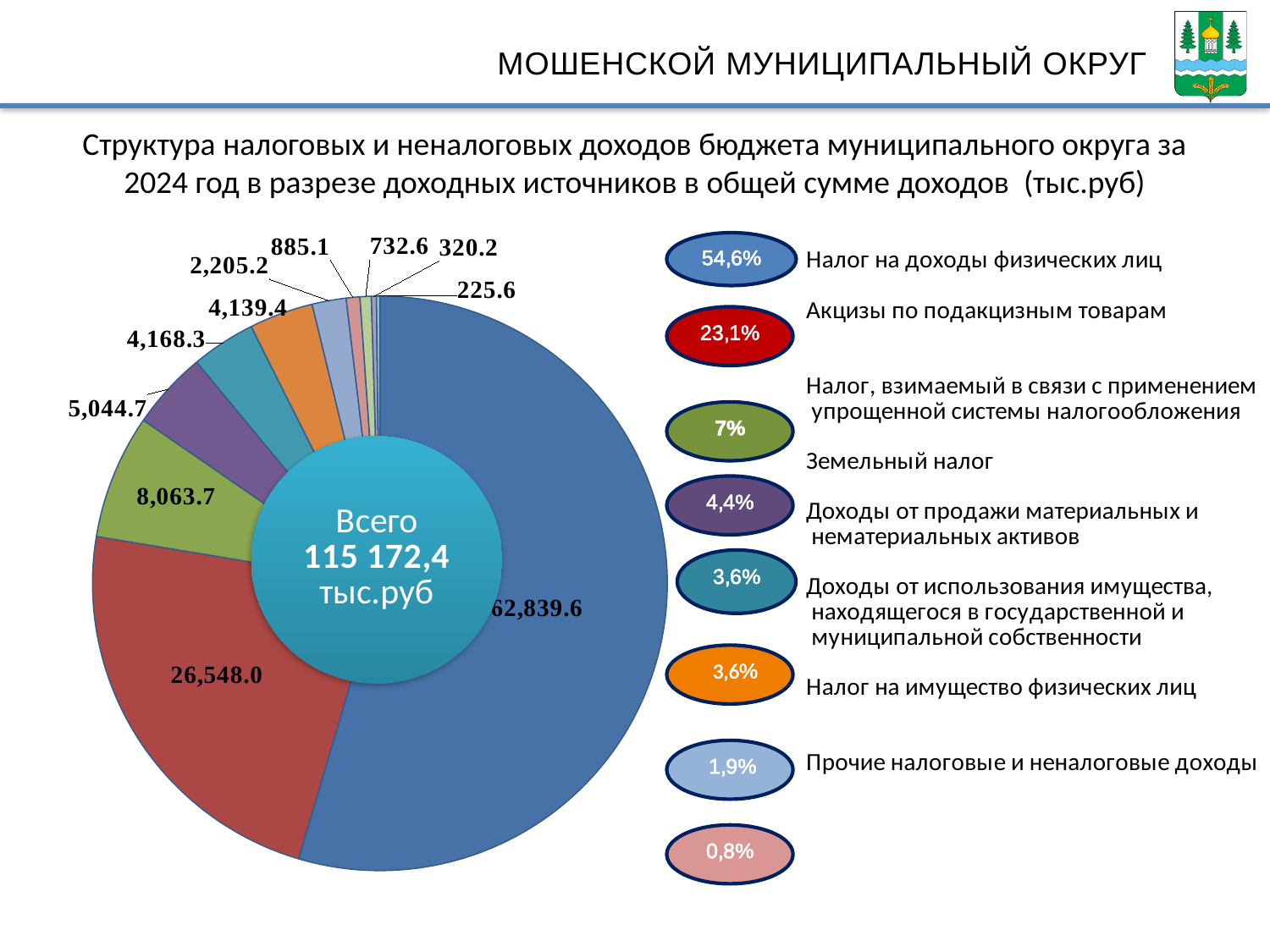
Which slice is larger: the one labelled 4,168.3 or the one labelled 4,139.4? 4,168.3 What percentage share is shown for Акцизы по подакцизным товарам? 23,1% What percentage share is shown for Налог на доходы физических лиц? 54,6% What kind of chart is shown on the slide? pie chart How many value labels are shown on the pie chart? 11 What is the difference between the largest slice (62,839.6) and the red slice (26,548.0)? 36,291.6 What is the value of the largest slice of the pie chart? 62,839.6 What is the total value shown in the centre of the pie chart? 115 172,4 тыс.руб What is the value of the smallest labelled slice of the pie chart? 225.6 What is the value of the red slice of the pie chart? 26,548.0 What is the value of the green slice of the pie chart? 8,063.7 How many percentage ovals are listed in the legend to the right of the pie chart? 8